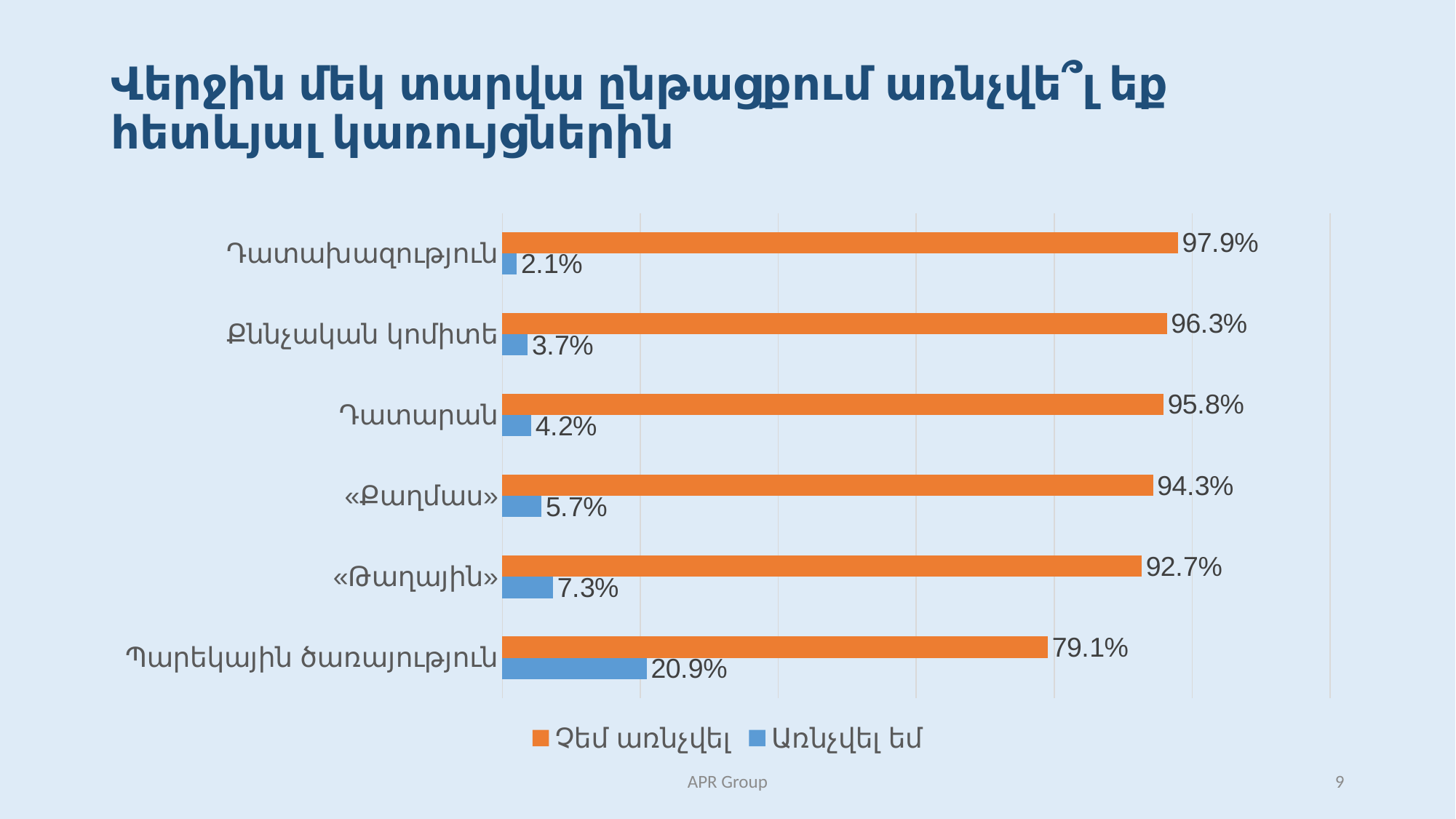
What is the value of «Չեմ առնչվել» for Դատախազություն? 97.9% How many series does the legend list? 2 What is the value of «Առնչվել եմ» for «Քաղմաս»? 5.7% What kind of chart is shown on the slide? Bar chart Which category has the highest «Առնչվել եմ» value? Պարեկային ծառայություն What is the difference between the «Առնչվել եմ» values for «Թաղային» and Դատարան? 3.1% What is the total of the two values for Դատարան? 100% What is the value of «Առնչվել եմ» for Պարեկային ծառայություն? 20.9% How many categories are shown in the chart? 6 Which category has the lowest «Չեմ առնչվել» value? Պարեկային ծառայություն Which colour represents the «Առնչվել եմ» series? Blue Which is larger: the «Չեմ առնչվել» value for Քննչական կոմիտե or for «Թաղային»? Քննչական կոմիտե